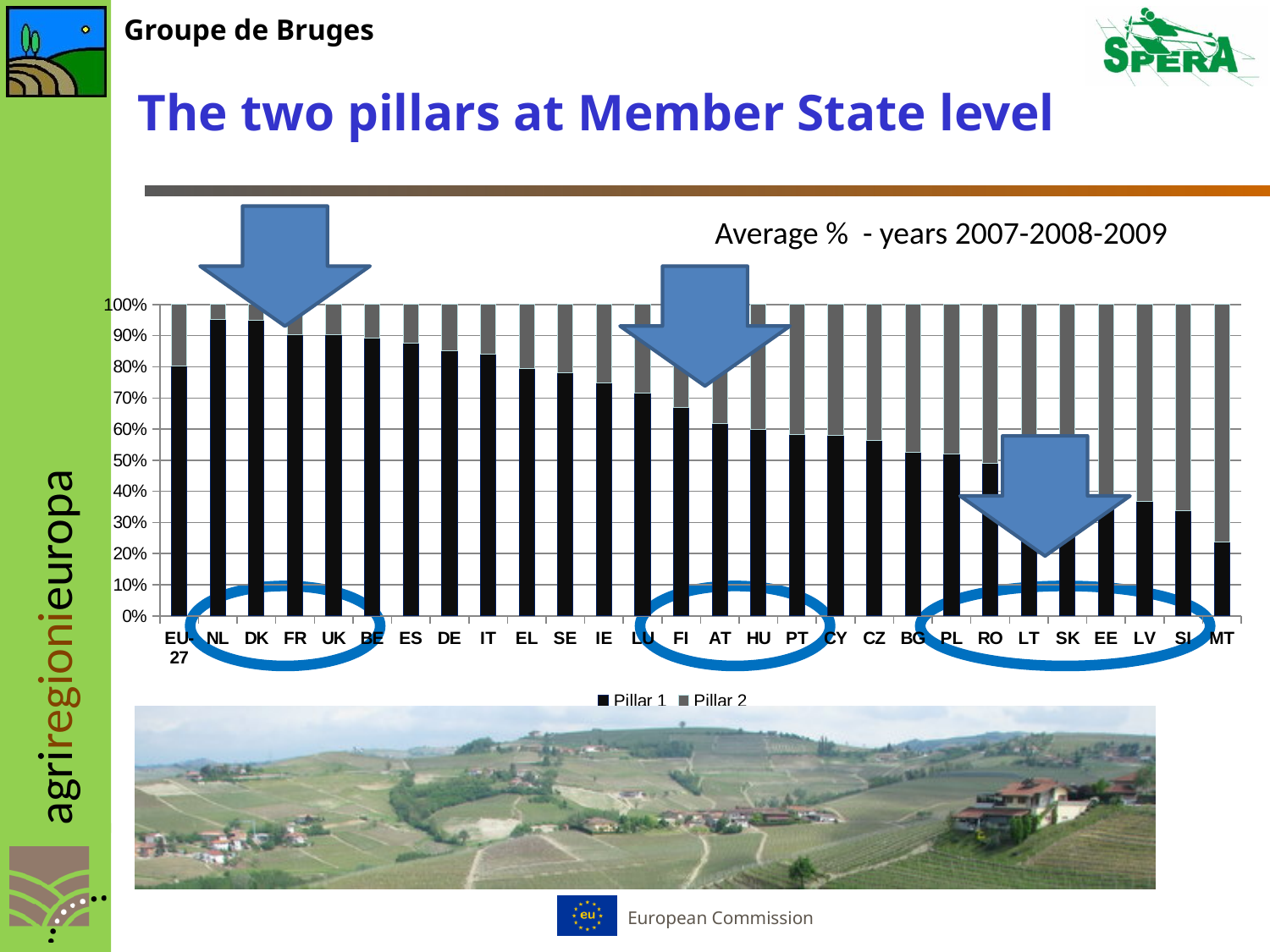
Is the Pillar 1 share for NL greater or less than 90%? greater How many Member State categories (including EU-27) are shown on the x axis? 28 Does the Pillar 1 share generally rise or fall moving from left to right along the x axis? Fall How many series does the chart legend list? 2 Which has a larger Pillar 1 share, DE or LV? DE What period does the chart subtitle say the averages cover? 2007-2008-2009 Which category has the highest Pillar 2 share? MT Is the Pillar 1 share for LT greater or less than 50%? less Which category has the lowest Pillar 1 share? MT Is the Pillar 1 share for FI greater or less than 60%? greater What kind of chart is shown on the slide? Stacked bar chart